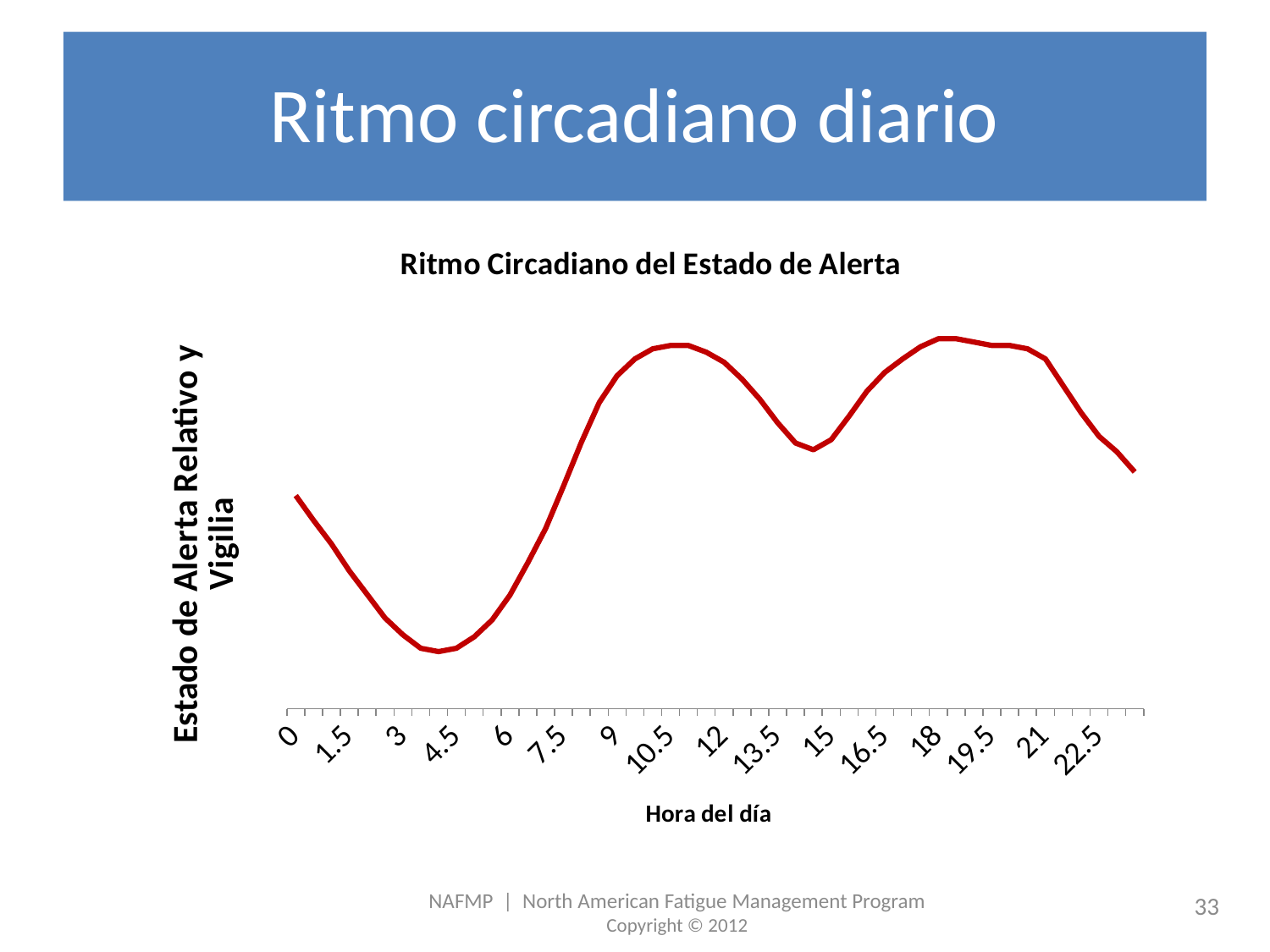
Around which labelled hour does the afternoon dip in alertness occur? 15 Is the alertness value at hour 6 or at hour 9 higher? 9 At which labelled hour of the day is the alertness level lowest? 4.5 Is the alertness value at hour 3 or at hour 12 higher? 12 Does the alertness level rise or fall between hour 4.5 and hour 10.5? rise Is the alertness value at hour 4.5 or at hour 15 higher? 15 Does the alertness level rise or fall between hour 0 and hour 4.5? fall What kind of chart is shown on the slide? line chart Does the alertness level rise or fall between hour 21 and hour 22.5? fall What is the label of the x axis? Hora del día How many labelled tick values are shown on the x axis? 16 What is the title of the chart? Ritmo Circadiano del Estado de Alerta